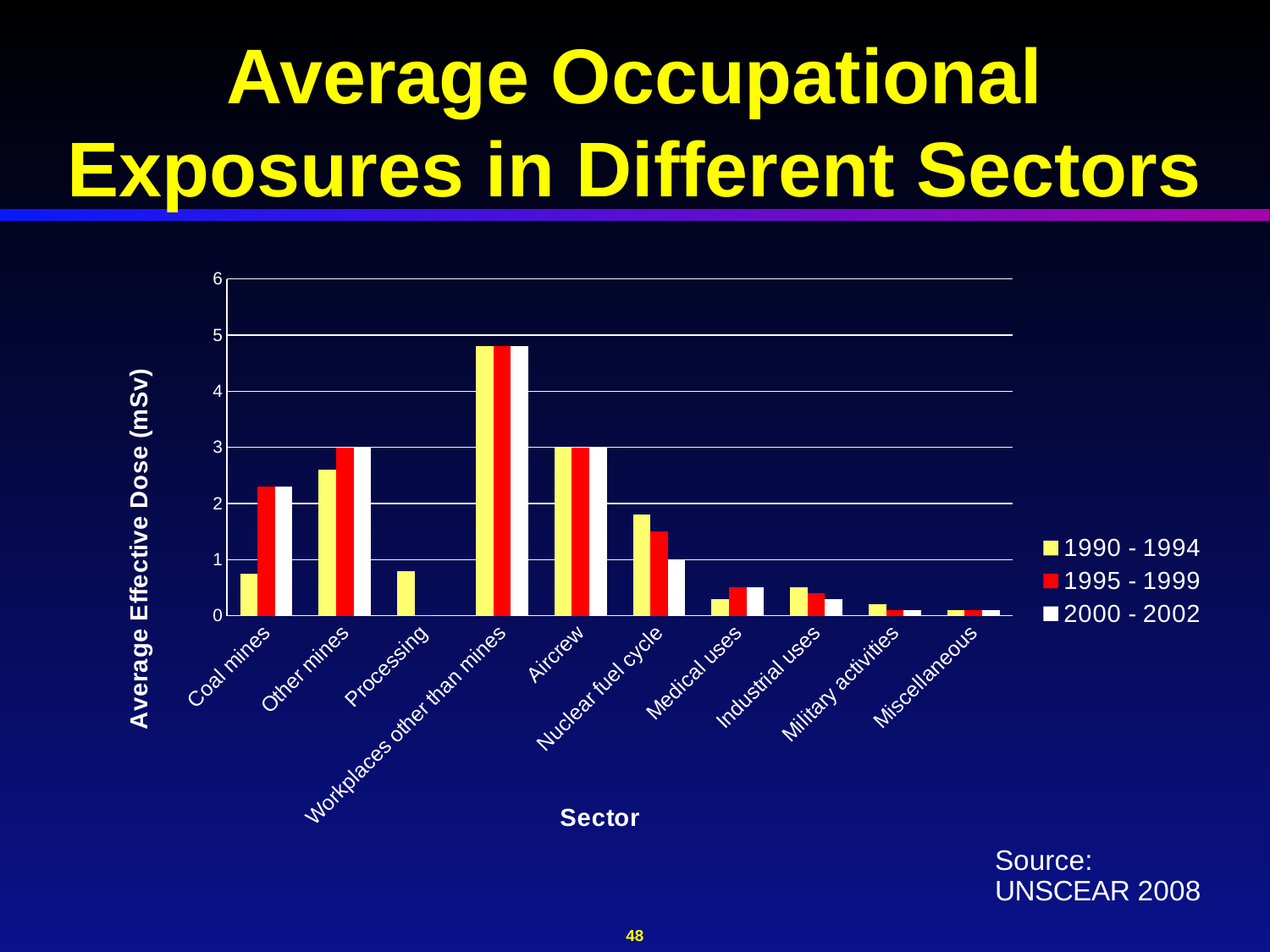
What is the average effective dose for Aircrew in 1990 - 1994? 3 Which sector has the highest average effective dose in the chart? Workplaces other than mines What is the label of the chart's y axis? Average Effective Dose (mSv) Is the value for Coal mines in 1990 - 1994 greater or less than 1? less For Nuclear fuel cycle, which period has the larger value: 1990 - 1994 or 2000 - 2002? 1990 - 1994 How many sectors are shown along the x axis of the chart? 10 Is the value for Workplaces other than mines in 1990 - 1994 greater or less than 4? greater How many series does the chart's legend list? 3 Is the value for Medical uses in 1995 - 1999 greater or less than 1? less What kind of chart is shown on the slide? bar chart Which period does the red series in the legend represent? 1995 - 1999 For Coal mines, which period has the larger value: 1990 - 1994 or 1995 - 1999? 1995 - 1999